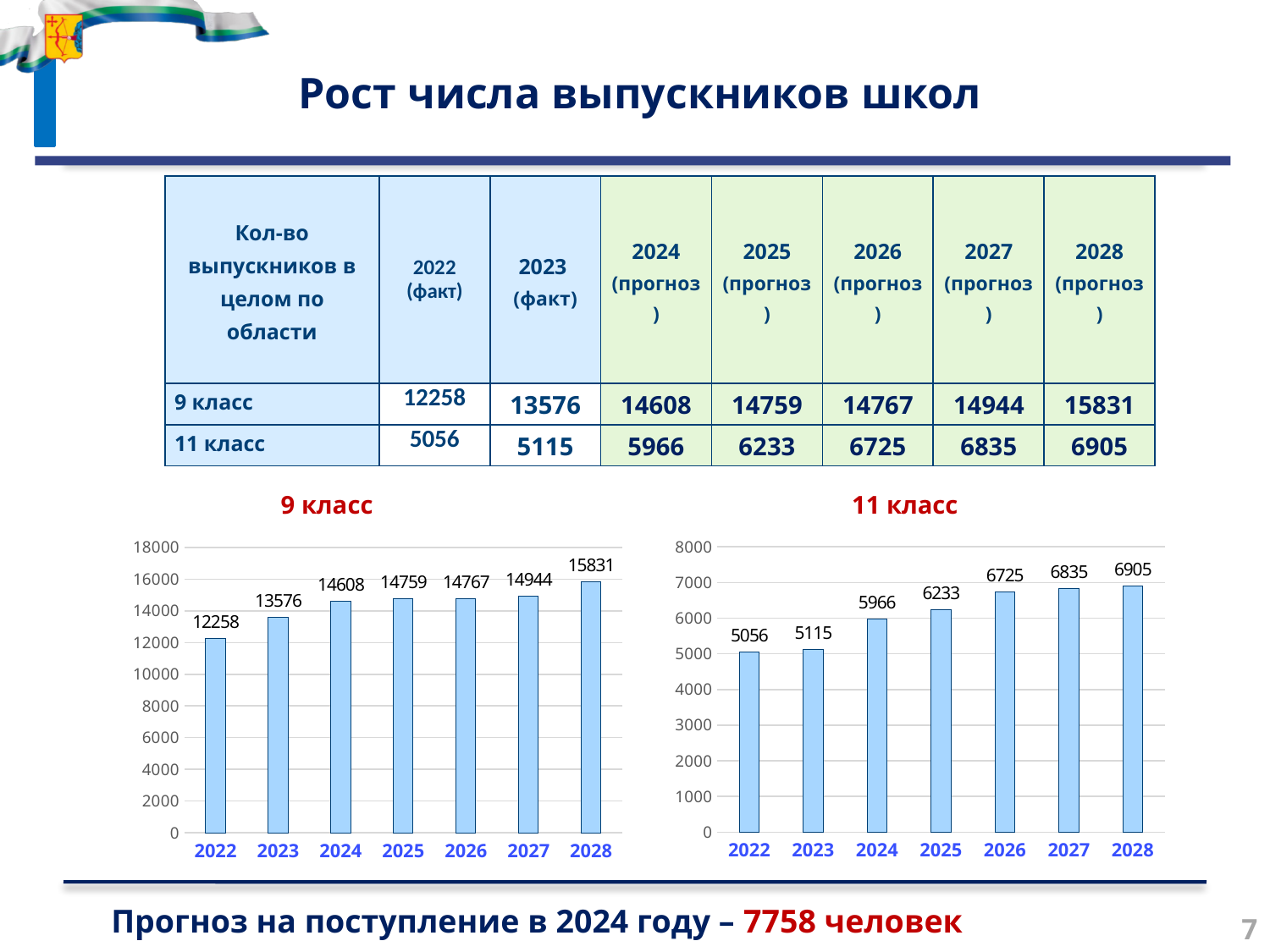
What kind of chart is the "11 класс" chart? bar chart In the "11 класс" chart, is the value for 2025 greater or less than 6000? greater What is the title of the chart on the left side of the slide? 9 класс In the "9 класс" chart, which is larger: the value for 2023 or the value for 2024? 2024 How many years are shown on the x axis of the "9 класс" chart? 7 In the "11 класс" chart, do the values rise or fall from 2022 to 2028? rise In the "9 класс" chart, which year has the highest value? 2028 In the "11 класс" chart, what is the difference between the values for 2024 and 2023? 851 In the "11 класс" chart, what is the value for 2026? 6725 In the "11 класс" chart, which year has the lowest value? 2022 In the "9 класс" chart, what is the difference between the values for 2028 and 2022? 3573 In the "9 класс" chart, what is the value for 2024? 14608